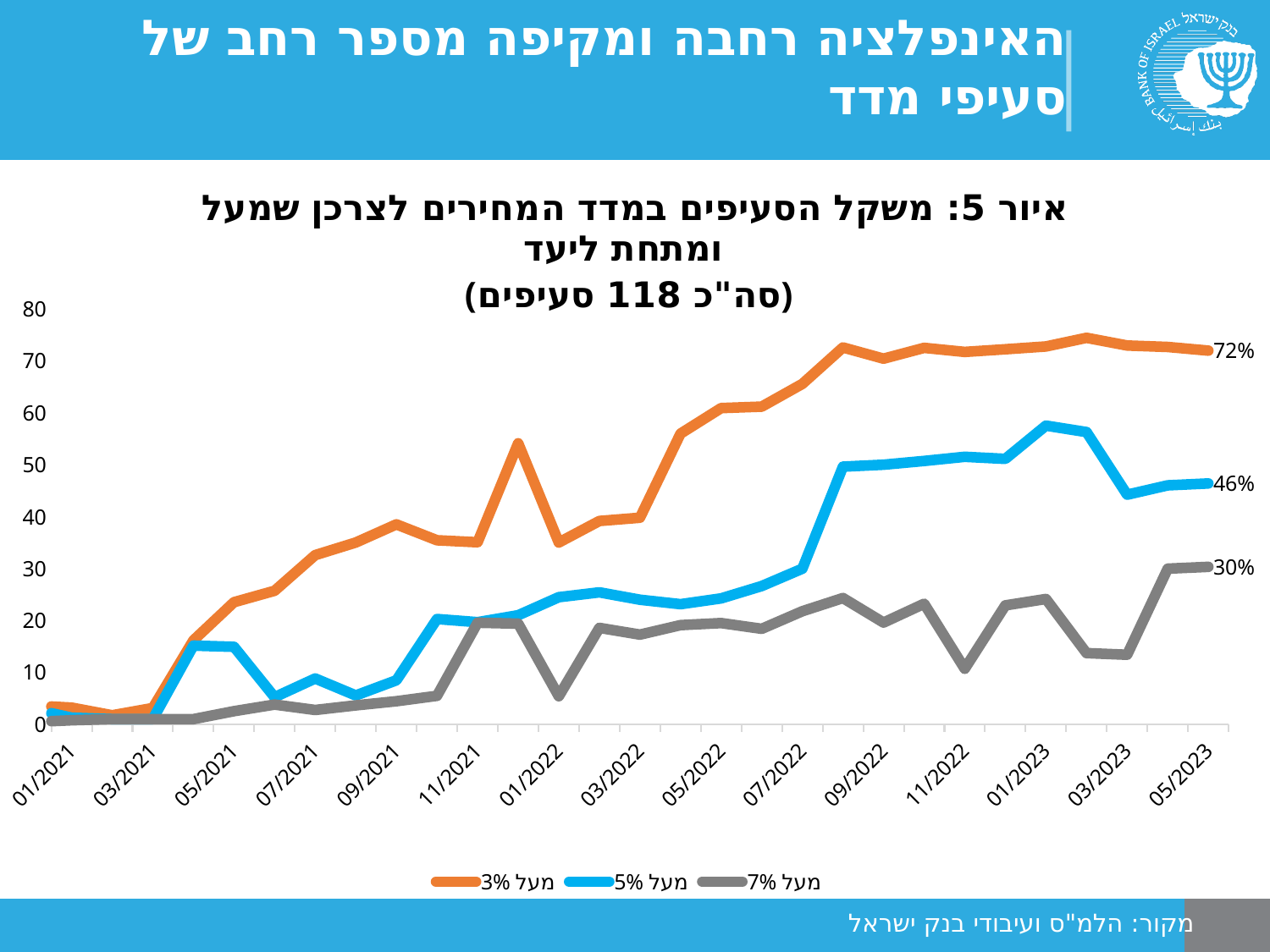
Which colour is used for the 'מעל 5%' series? blue How many series does the legend list? 3 Which series has the highest value at 05/2023? מעל 3% Does the 'מעל 3%' series generally rise or fall from 01/2021 to 05/2023? rise What is the final value (05/2023) of the 'מעל 7%' series? 30% What is the final value (05/2023) of the 'מעל 5%' series? 46% Is the value of the 'מעל 7%' series at 01/2022 greater or less than 10? less What type of chart is shown on the slide? line chart Is the value of the 'מעל 3%' series at 09/2022 greater or less than 60? greater What is the difference between the 'מעל 3%' and 'מעל 5%' values at 05/2023? 26% Which series has the lowest value at 05/2023? מעל 7% What is the final value (05/2023) of the 'מעל 3%' series? 72%